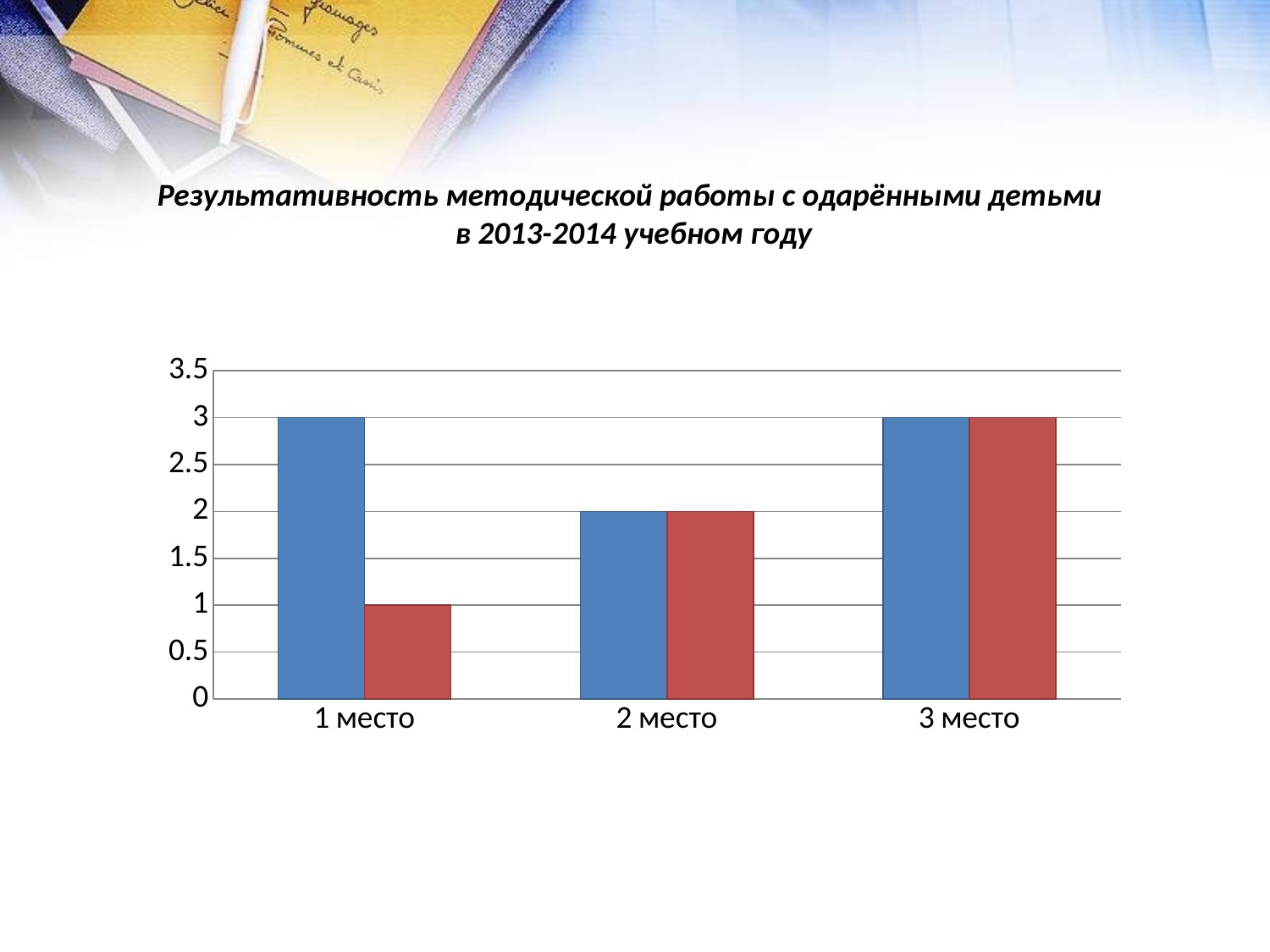
For which category is the red bar lowest? 1 место Which is larger for "1 место", the blue bar or the red bar? the blue bar What type of chart is shown on the slide? bar chart What is the value of the red bar for "3 место"? 3 What is the value of the blue bar for "1 место"? 3 What is the difference between the blue bar and the red bar for "1 место"? 2 What is the value of the blue bar for "2 место"? 2 What is the title of the slide containing the chart? Результативность методической работы с одарёнными детьми в 2013-2014 учебном году How many categories are shown on the x axis of the chart? 3 Do the red bars rise or fall from "1 место" to "3 место"? rise What is the value of the red bar for "1 место"? 1 For which category is the blue bar lowest? 2 место